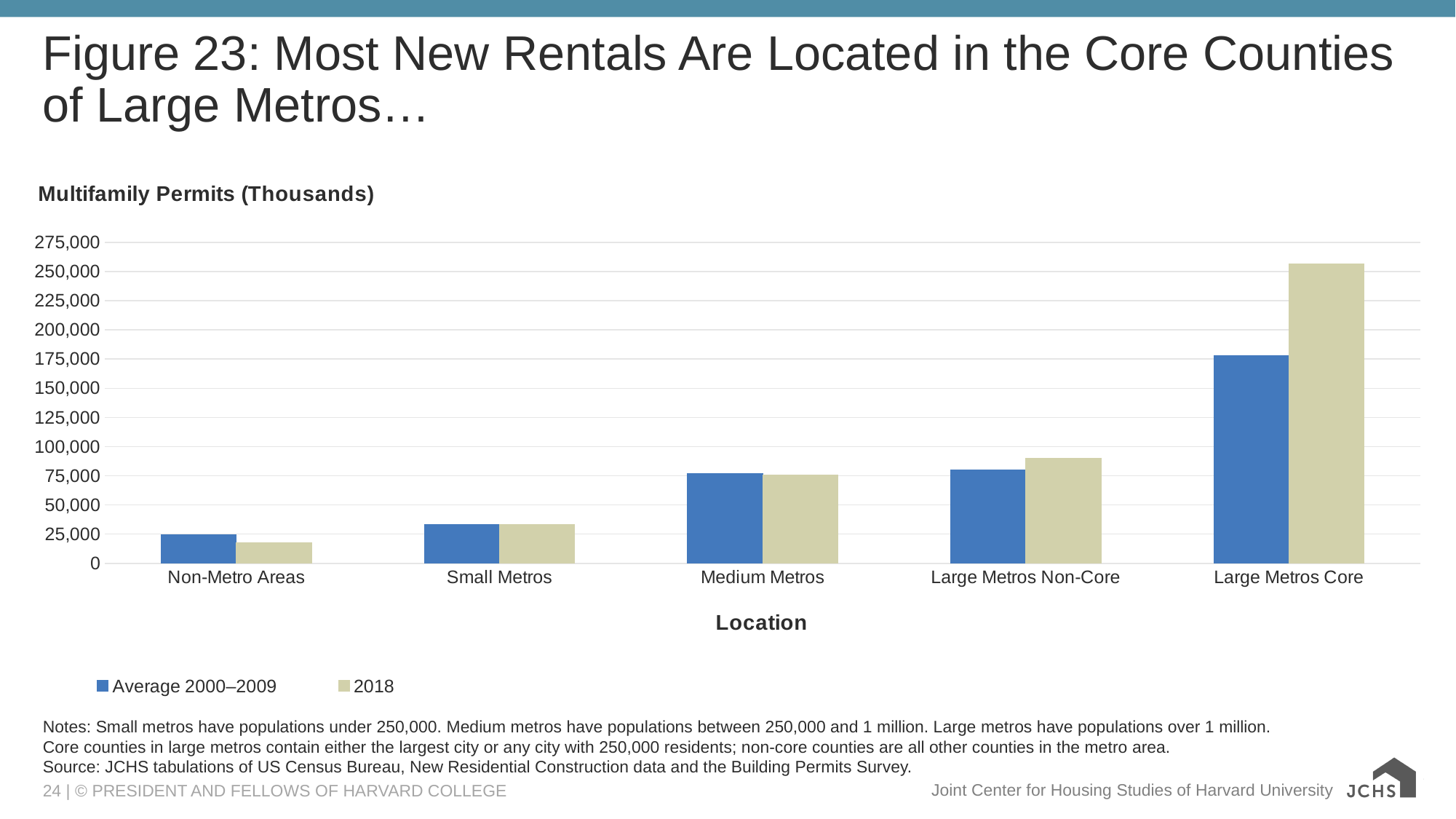
For Large Metros Core, which is larger: the Average 2000–2009 value or the 2018 value? 2018 Which location has the highest value for the Average 2000–2009 series? Large Metros Core Is the 2018 value for Non-Metro Areas greater or less than 25,000? less What is the title of the x axis? Location How many series does the legend list? 2 Which location has the lowest value for the 2018 series? Non-Metro Areas Which location has the highest value for the 2018 series? Large Metros Core What kind of chart is shown on the slide? Bar chart Is the 2018 value for Large Metros Core greater or less than 200,000? greater For Non-Metro Areas, which is larger: the Average 2000–2009 value or the 2018 value? Average 2000–2009 How many location categories are shown on the x axis? 5 Is the Average 2000–2009 value for Large Metros Core greater or less than 150,000? greater